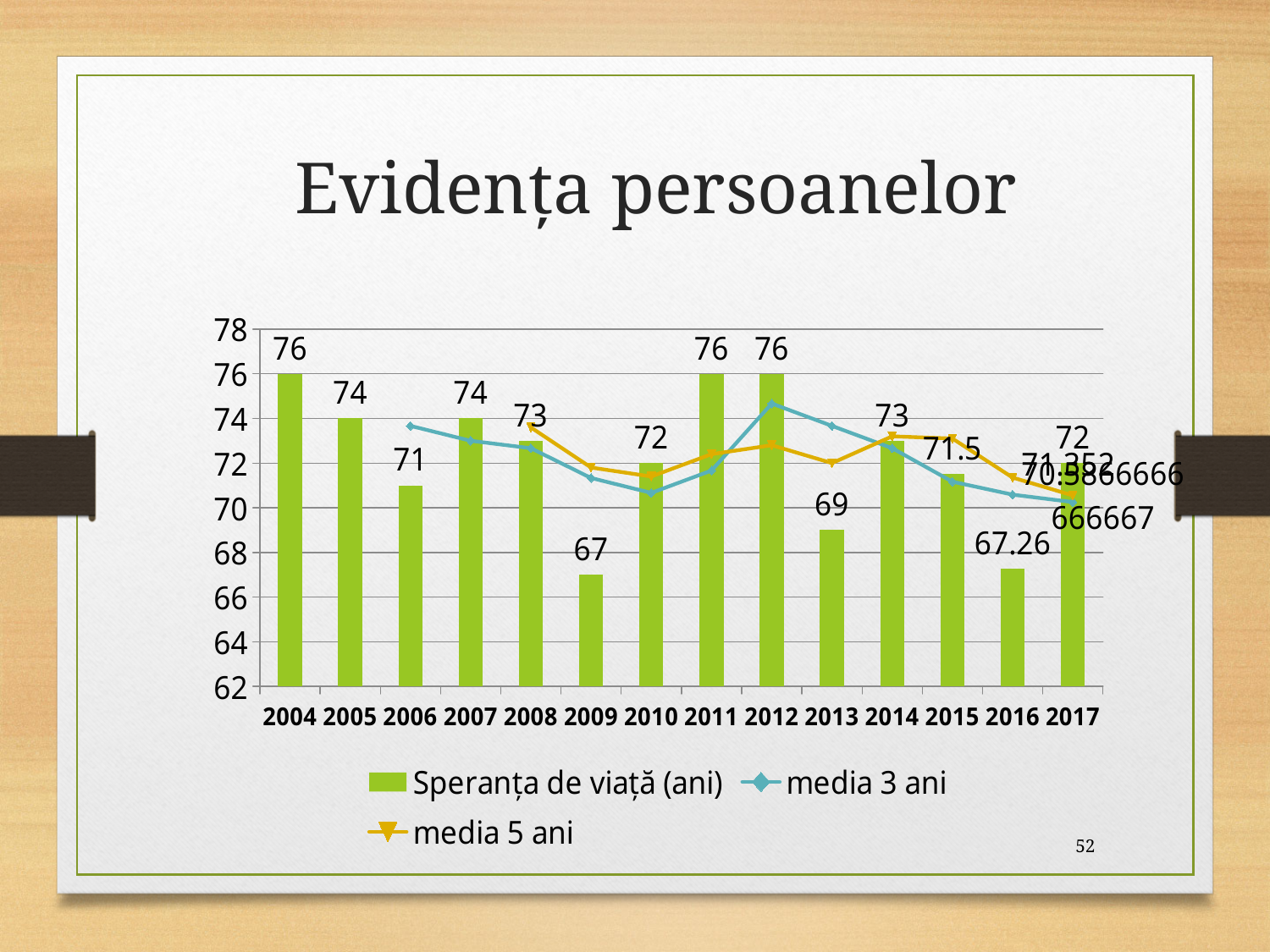
How many series does the legend list? 3 Which is larger, the Speranța de viață (ani) value for 2008 or for 2010? 2008 What is the difference between the Speranța de viață (ani) values for 2012 and 2013? 7 What is the value of Speranța de viață (ani) for 2004? 76 Is the media 5 ani value for 2010 greater or less than 72? less Is the media 3 ani value for 2012 greater or less than 74? greater What is the title of the slide containing the chart? Evidența persoanelor What is the value of Speranța de viață (ani) for 2016? 67.26 What is the value of Speranța de viață (ani) for 2015? 71.5 What kind of chart is shown on the slide? Combined bar and line chart Which year has the lowest value for Speranța de viață (ani)? 2009 How many years are shown on the x axis? 14